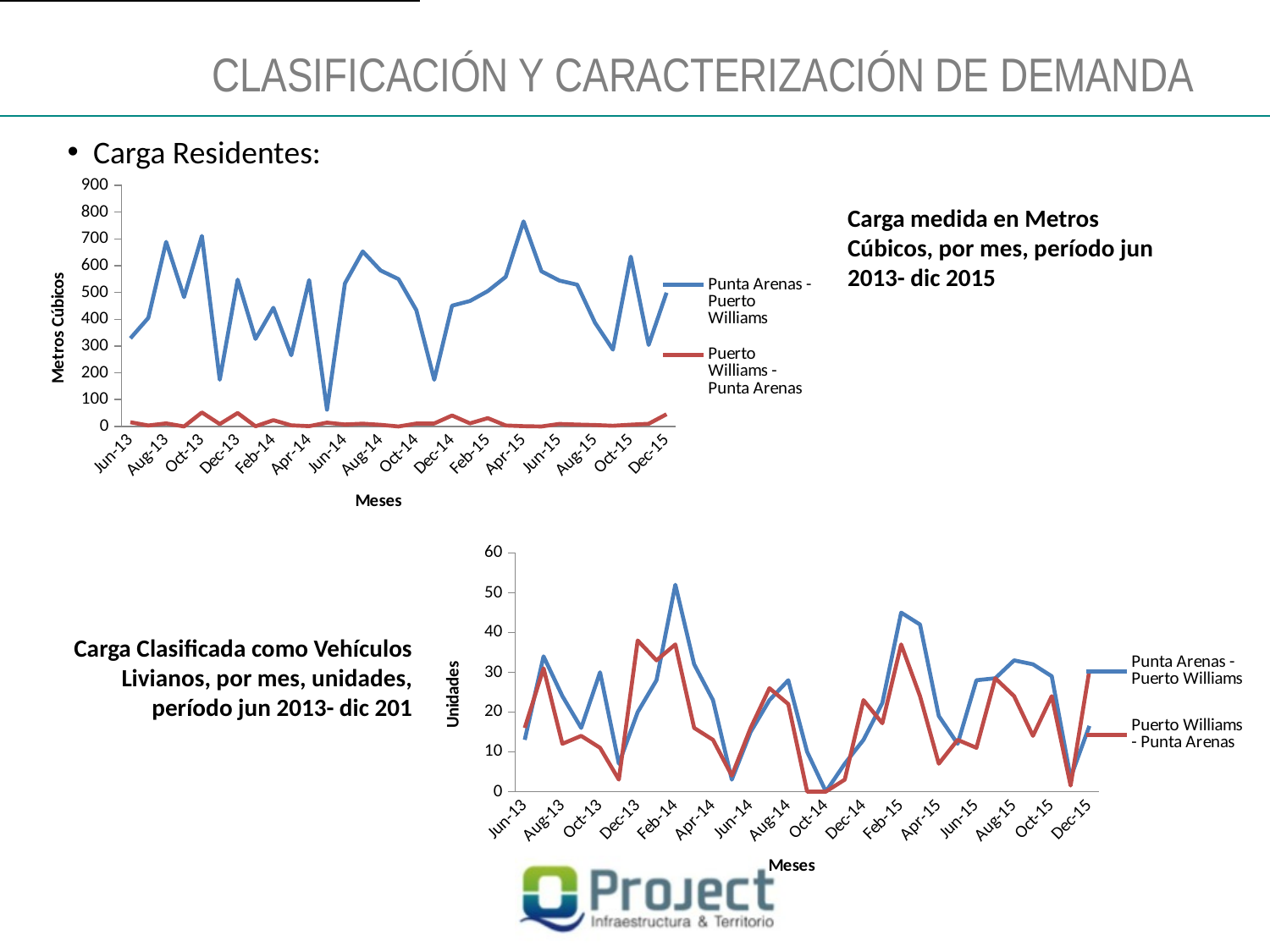
What is the y-axis title of the top chart? Metros Cúbicos In the top chart (Metros Cúbicos), in which month does the Punta Arenas - Puerto Williams series reach its highest value? Apr-15 What kind of chart is the top chart (Metros Cúbicos)? line chart In the bottom chart (Unidades), in which month does the Punta Arenas - Puerto Williams series reach its highest value? Feb-14 In the top chart (Metros Cúbicos), how many series does the legend list? 2 In the top chart (Metros Cúbicos), is the value for Punta Arenas - Puerto Williams in Apr-15 greater or less than 700? greater In the bottom chart (Unidades), how many series does the legend list? 2 What kind of chart is the bottom chart (Unidades)? line chart In the bottom chart (Unidades), is the value for Punta Arenas - Puerto Williams in Feb-14 greater or less than 50? greater In the top chart (Metros Cúbicos), is the value for Punta Arenas - Puerto Williams in Jun-14 greater or less than 100? greater In the top chart (Metros Cúbicos), which series has the higher values across the period, Punta Arenas - Puerto Williams or Puerto Williams - Punta Arenas? Punta Arenas - Puerto Williams